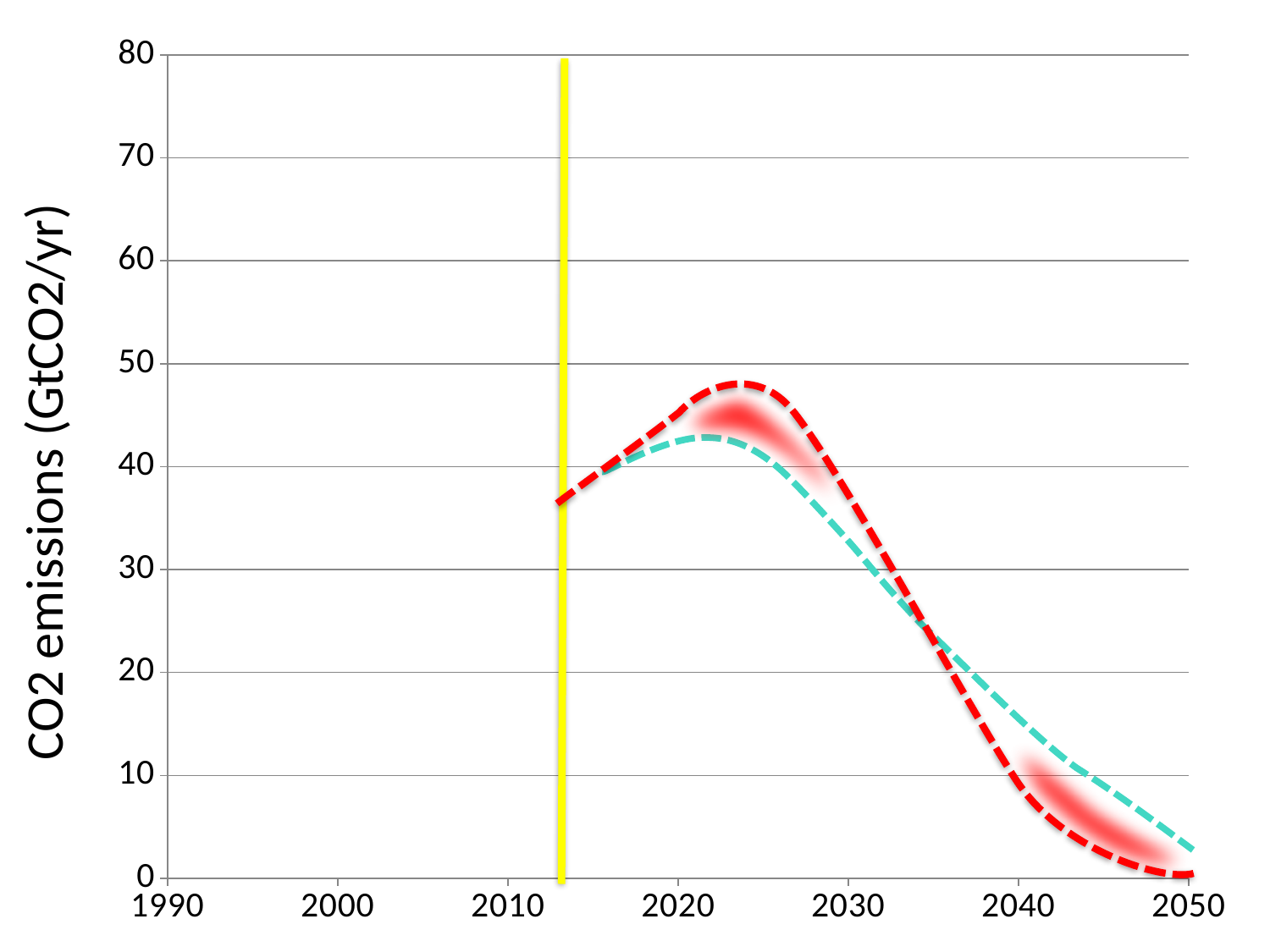
What kind of chart is shown on the slide? line chart Do the plotted lines rise or fall between 2030 and 2050? fall Is the value of the teal dashed line at 2040 greater or less than 10? greater How many dashed lines are plotted on the chart? 2 Is the value of the teal dashed line at 2030 greater or less than 40? less Is the peak value of the red dashed line greater or less than 40? greater What is the label on the vertical axis? CO2 emissions (GtCO2/yr) What is the highest value shown on the vertical axis? 80 Around 2045, which line is higher, the red dashed line or the teal dashed line? the teal dashed line Around 2025, which line is higher, the red dashed line or the teal dashed line? the red dashed line